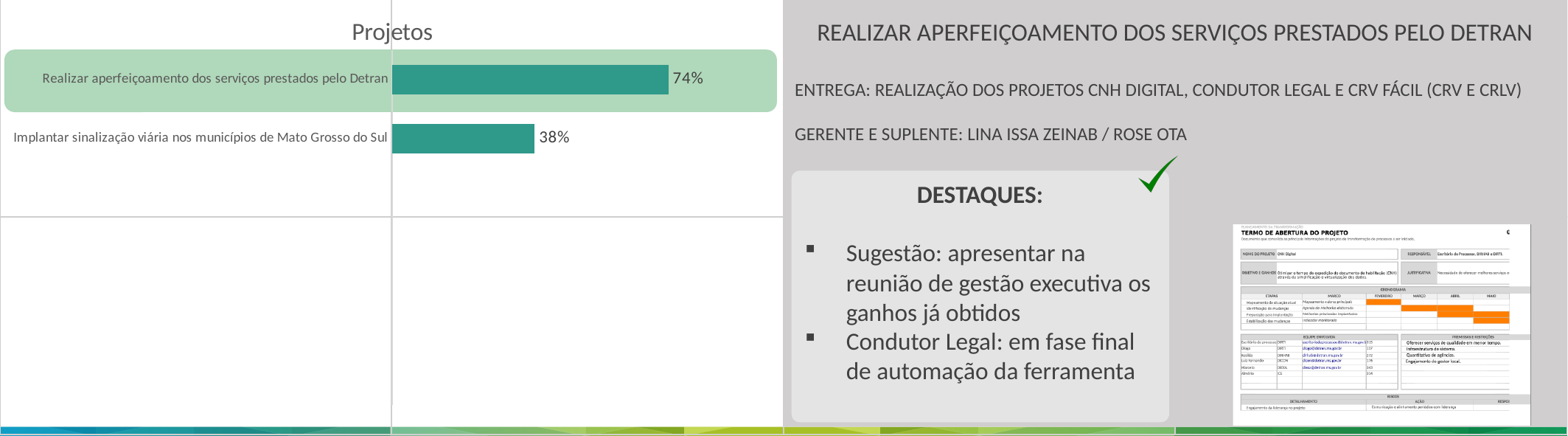
What is the value for "Realizar aperfeiçoamento dos serviços prestados pelo Detran" in the Projetos chart? 74% Are the bars in the Projetos chart horizontal or vertical? Horizontal What is the value for "Implantar sinalização viária nos municípios de Mato Grosso do Sul" in the Projetos chart? 38% What is the difference between the two values shown in the Projetos chart? 36% Which project has the lowest value in the Projetos chart? Implantar sinalização viária nos municípios de Mato Grosso do Sul What kind of chart is the Projetos chart? Bar chart Which is larger in the Projetos chart: the value for "Realizar aperfeiçoamento dos serviços prestados pelo Detran" or for "Implantar sinalização viária nos municípios de Mato Grosso do Sul"? Realizar aperfeiçoamento dos serviços prestados pelo Detran Which project has the highest value in the Projetos chart? Realizar aperfeiçoamento dos serviços prestados pelo Detran What is the title of the chart on the slide? Projetos How many projects are plotted in the Projetos chart? 2